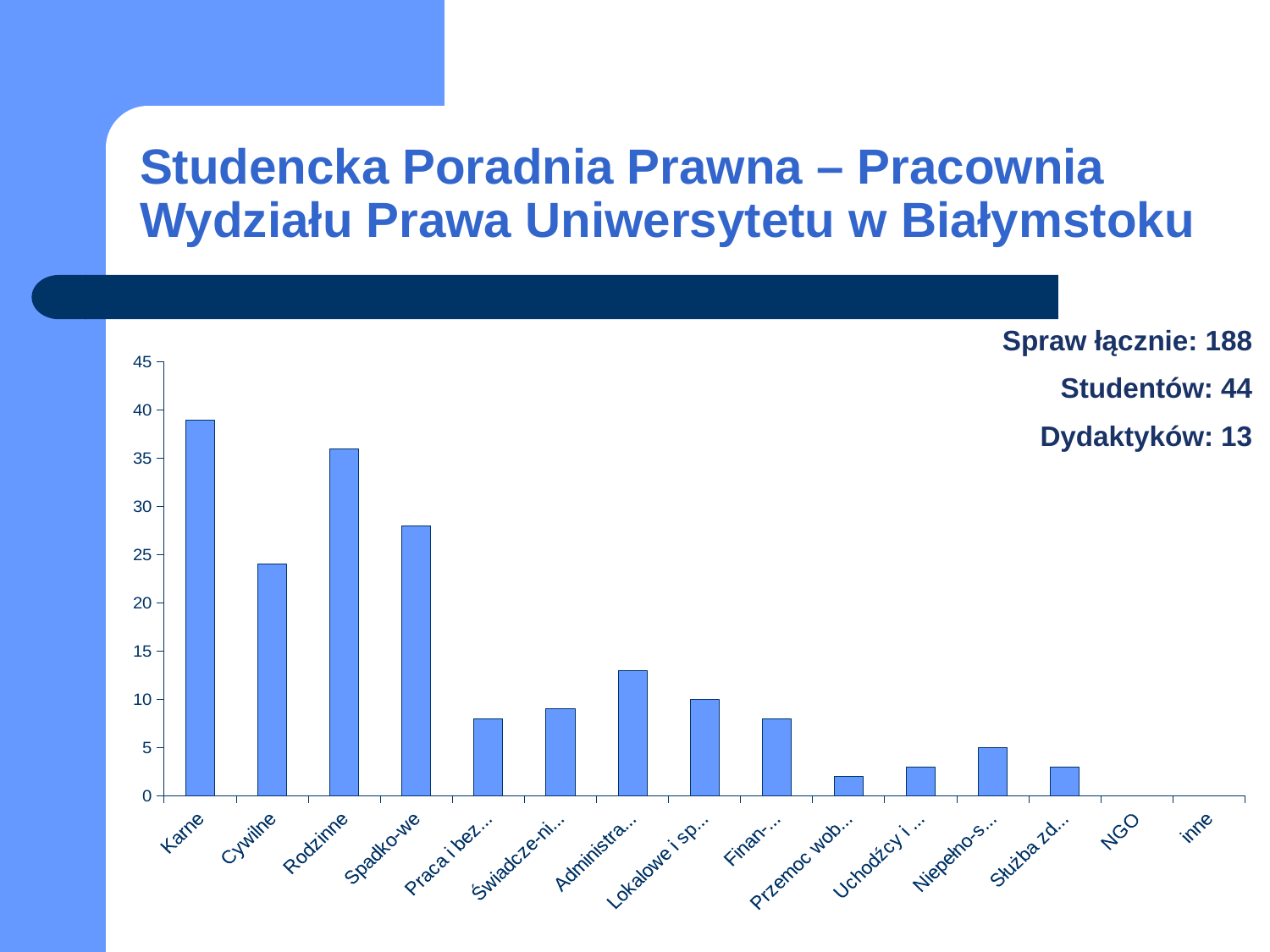
Which is larger, the value for Cywilne or the value for Spadko-we? Spadko-we What kind of chart is shown on the slide? bar chart What is the highest tick value shown on the y axis of the chart? 45 Which category has the highest bar in the chart? Karne Is the value for Administra... greater or less than 10? greater How many categories are shown on the x axis of the chart? 15 Is the value for Spadko-we greater or less than 25? greater Is the value for Karne greater or less than 35? greater Which is larger, the value for Karne or the value for Rodzinne? Karne